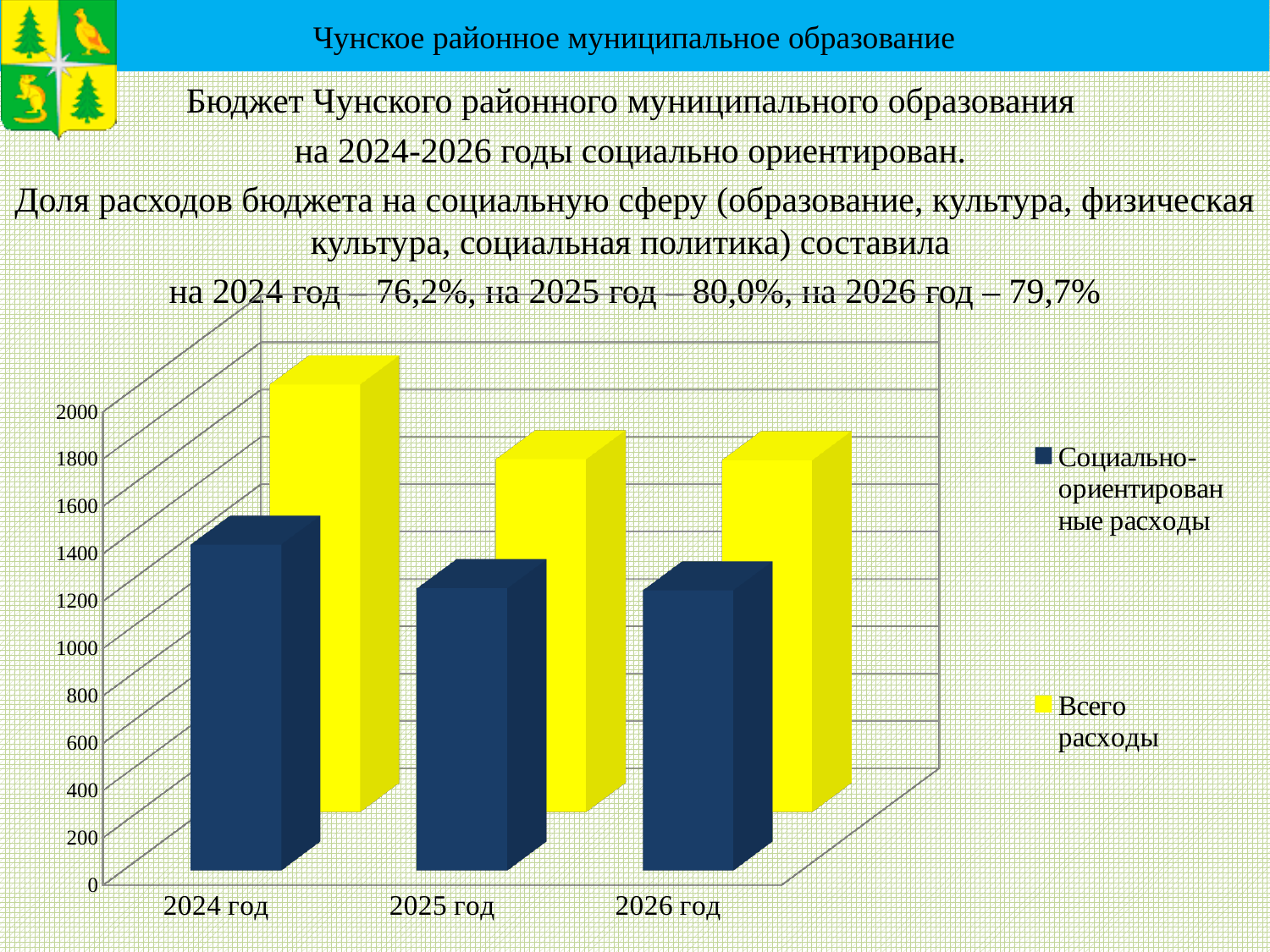
What kind of chart is shown on the slide? bar chart Which year has the highest value for Социально-ориентированные расходы? 2024 год How many series does the chart legend list? 2 Which is larger: Социально-ориентированные расходы in 2024 год or in 2025 год? 2024 год Is the value for Всего расходы in 2024 год greater or less than 1600? greater How many year categories are shown on the x axis of the chart? 3 Is the value for Социально-ориентированные расходы in 2025 год greater or less than 1400? less Is the value for Всего расходы in 2026 год greater or less than 1400? greater Which year has the highest value for Всего расходы? 2024 год Which colour represents Всего расходы in the chart? yellow Do the values for Всего расходы rise or fall from 2024 год to 2025 год? fall